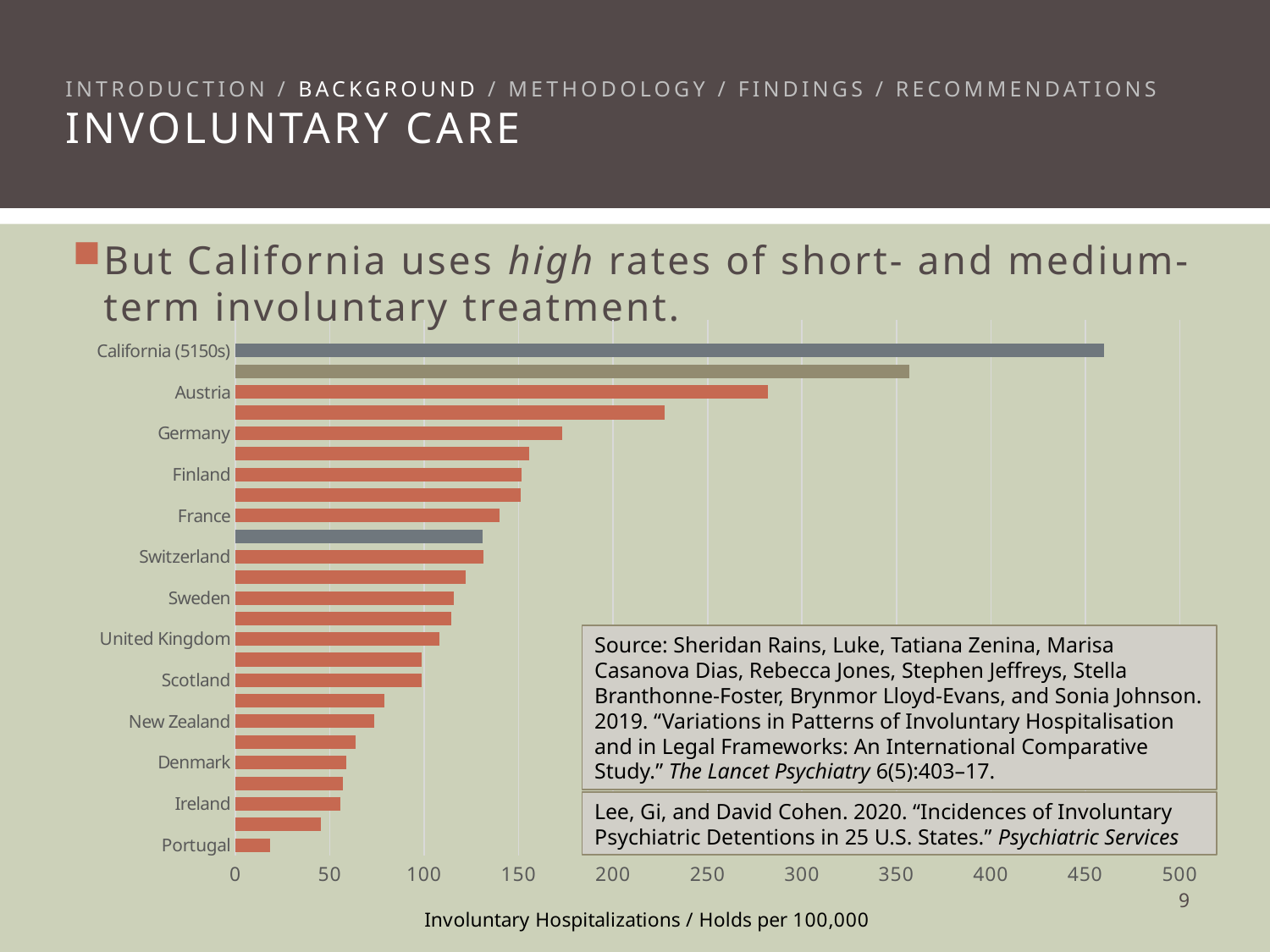
Is the value for California (5150s) greater or less than 400? greater Is the value for New Zealand greater or less than 50? greater Which category has the highest value in the chart? California (5150s) Is the value for Austria greater or less than 250? greater Which has a larger value, Sweden or Denmark? Sweden What kind of chart is shown on the slide? bar chart What is the title of the horizontal axis? Involuntary Hospitalizations / Holds per 100,000 Which has a larger value, Austria or Germany? Austria Which category has the lowest value in the chart? Portugal